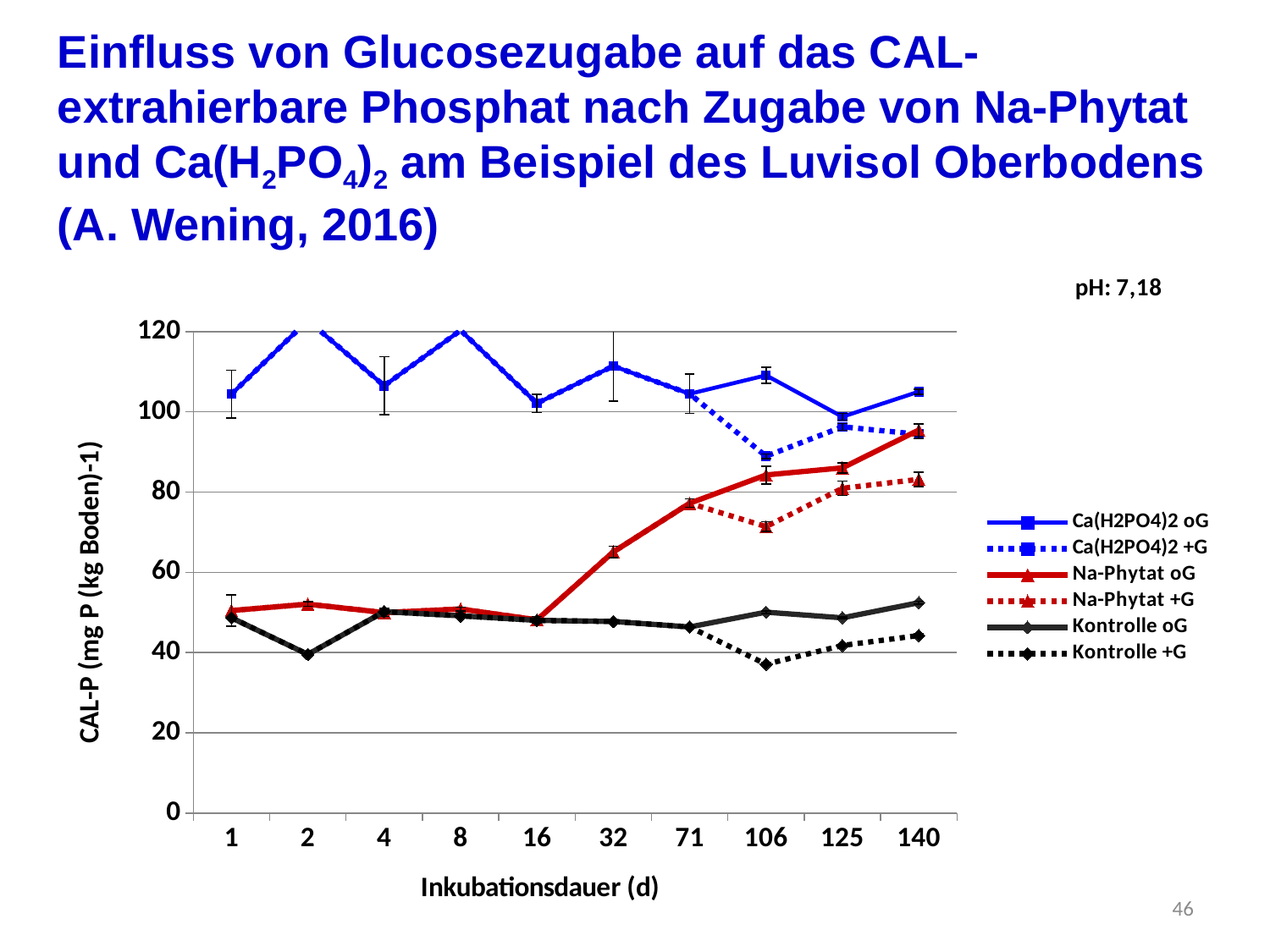
At 106 d, which is larger: Ca(H2PO4)2 oG or Ca(H2PO4)2 +G? Ca(H2PO4)2 oG How many series does the legend list? 6 Does the Na-Phytat oG series rise or fall between 16 d and 106 d? rise Is the value for Na-Phytat +G at 106 d greater or less than 80? less What kind of chart is shown on the slide? line chart Which series has the highest value at 140 d? Ca(H2PO4)2 oG Is the value for Na-Phytat oG at 32 d greater or less than 60? greater What is the x-axis title of the chart? Inkubationsdauer (d) How many incubation durations (x-axis categories) are plotted? 10 Is the value for Ca(H2PO4)2 +G at 106 d greater or less than 100? less At 140 d, which is larger: Na-Phytat oG or Kontrolle oG? Na-Phytat oG